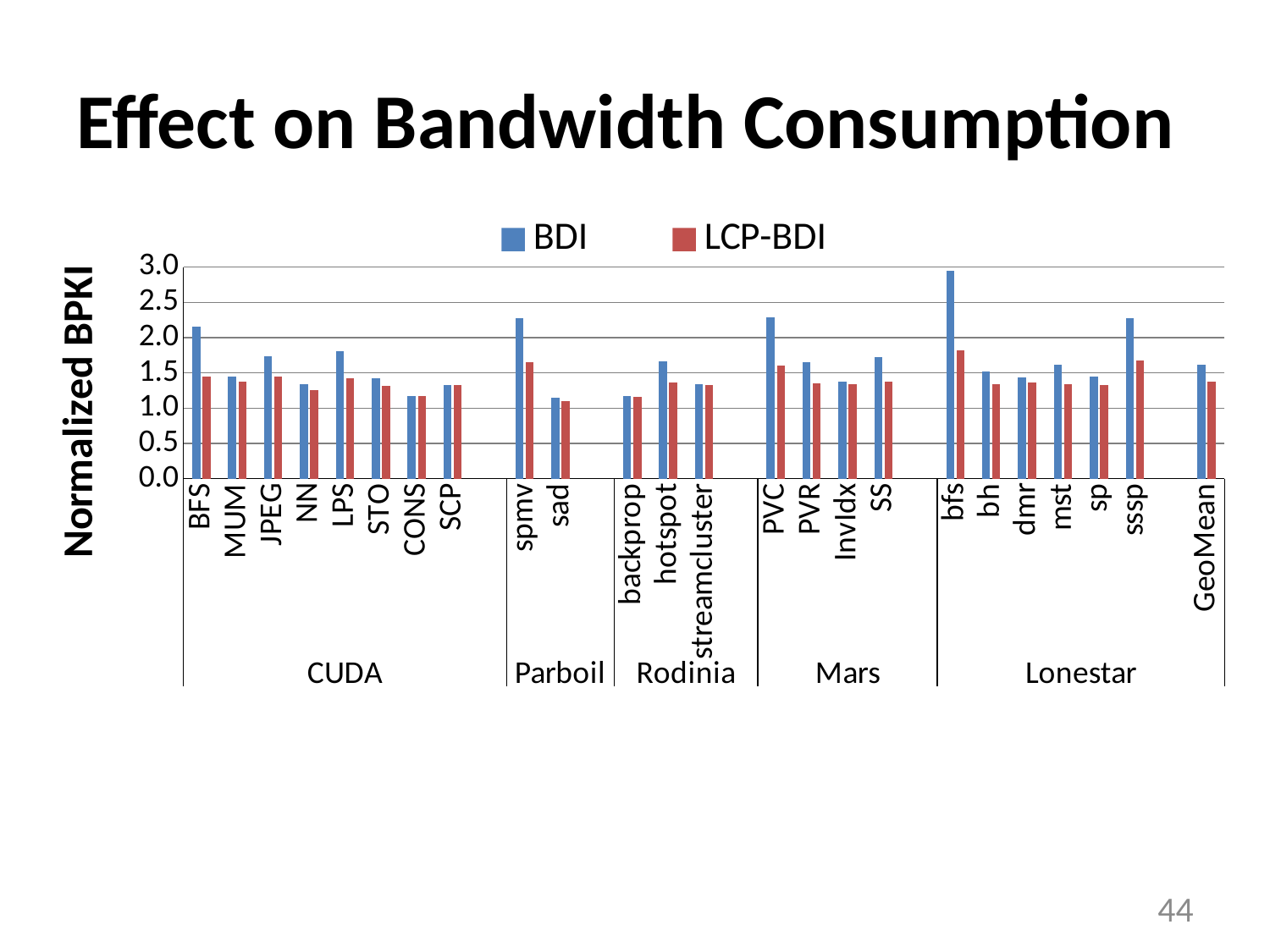
Is the BDI value for CONS greater or less than 1.5? less Which has the larger BDI value: spmv or sad? spmv Which benchmark has the highest BDI value? bfs Is the LCP-BDI value for bfs (Lonestar) greater or less than 2.0? less How many benchmarks are in the CUDA group on the x axis? 8 Which benchmark suite groups are labelled along the x axis? CUDA, Parboil, Rodinia, Mars, Lonestar How many series does the legend list? 2 Is the BDI value for spmv greater or less than 2.0? greater For PVC, which is larger: the BDI value or the LCP-BDI value? BDI What is the label of the vertical axis? Normalized BPKI What kind of chart is shown on the slide? bar chart